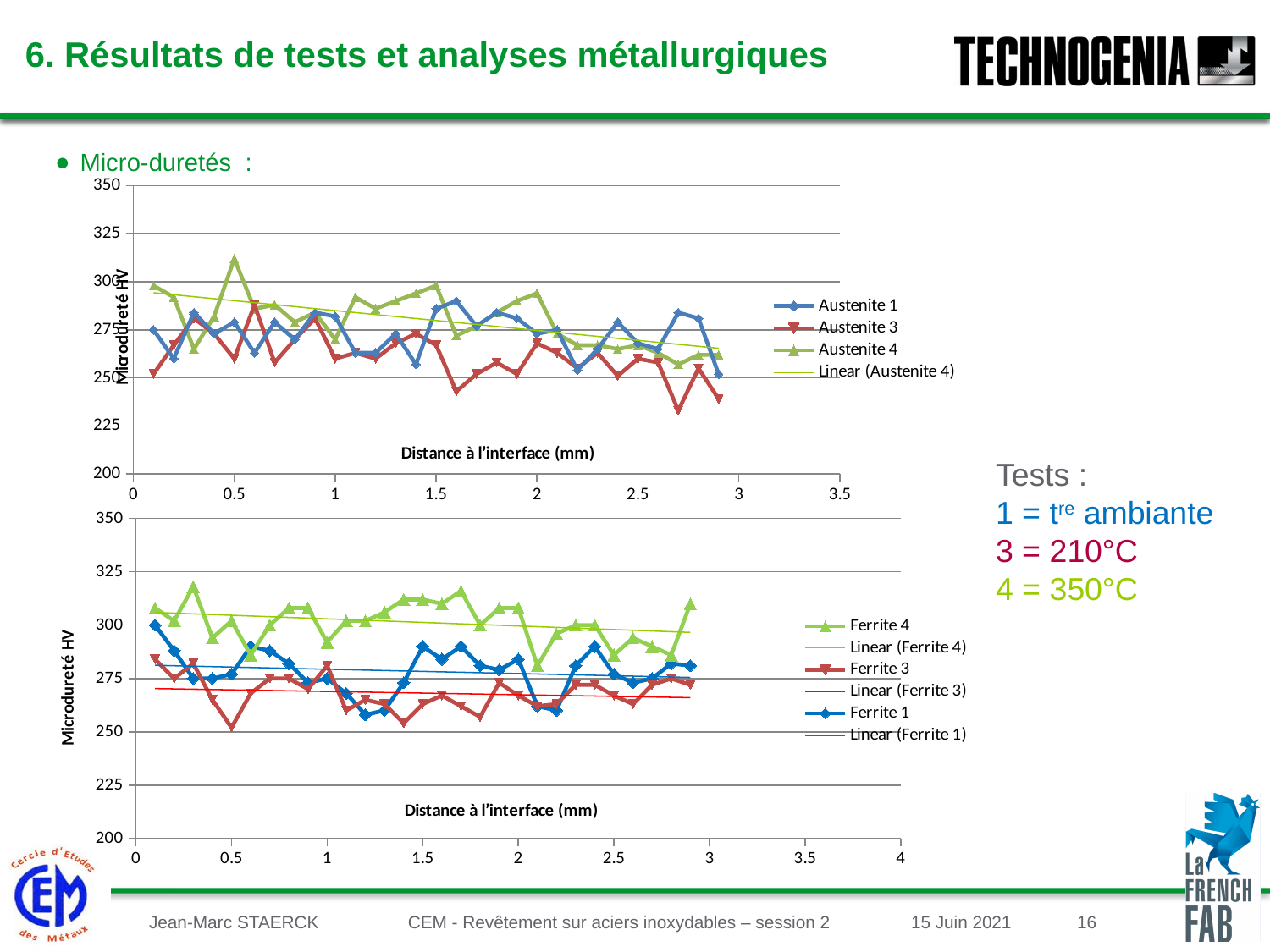
What kind of chart is the top chart on the slide? line chart In the top chart, is the value of Austenite 3 at a distance of 2.7 mm greater or less than 250? less In the bottom chart, is the value of Ferrite 4 at a distance of 0.3 mm greater or less than 300? greater In the top chart, does the Linear (Austenite 4) trend line rise or fall as distance increases? fall In the bottom chart, is the value of Ferrite 3 at a distance of 0.5 mm greater or less than 275? less What is the label of the y axis on the bottom chart? Microdureté HV In the top chart, which is larger at a distance of 0.5 mm: Austenite 4 or Austenite 3? Austenite 4 In the bottom chart, which series has the highest values overall? Ferrite 4 How many entries does the legend of the top chart list? 4 What is the label of the x axis on the bottom chart? Distance à l'interface (mm) How many entries does the legend of the bottom chart list? 6